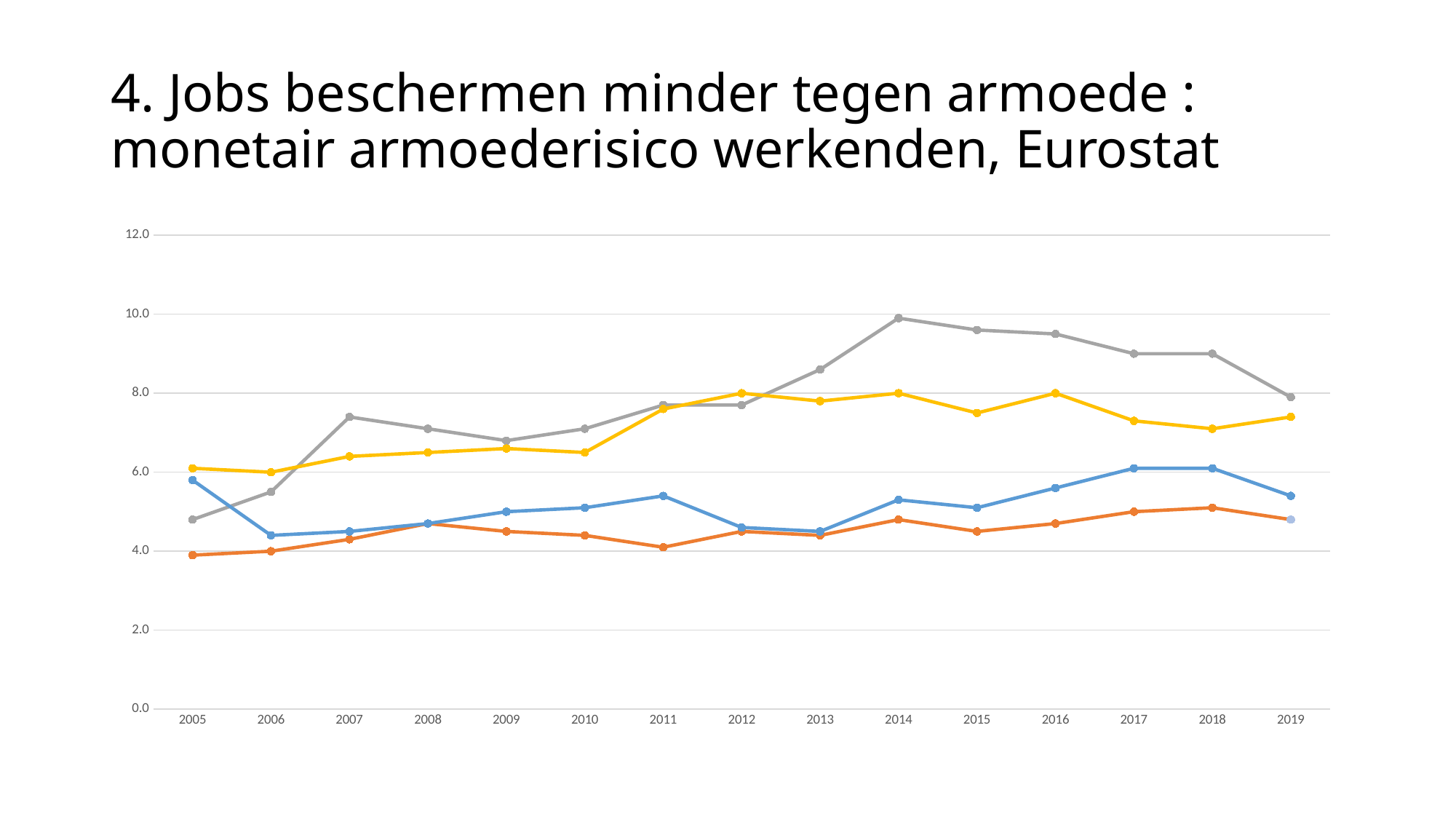
How many years are shown along the x axis of the chart? 15 In 2005, which line has the higher value, the yellow line or the gray line? yellow line Does the gray line generally rise or fall between 2005 and 2014? rise How many lines are plotted on the chart? 4 Is the value of the yellow line in 2012 greater or less than 6.0? greater In which year does the gray line reach its highest value? 2014 What kind of chart is shown on the slide? line chart Is the value of the blue line in 2019 greater or less than 6.0? less Is the value of the orange line in 2011 greater or less than 6.0? less What is the highest value shown on the y axis of the chart? 12.0 In 2019, which line has the higher value, the yellow line or the gray line? gray line